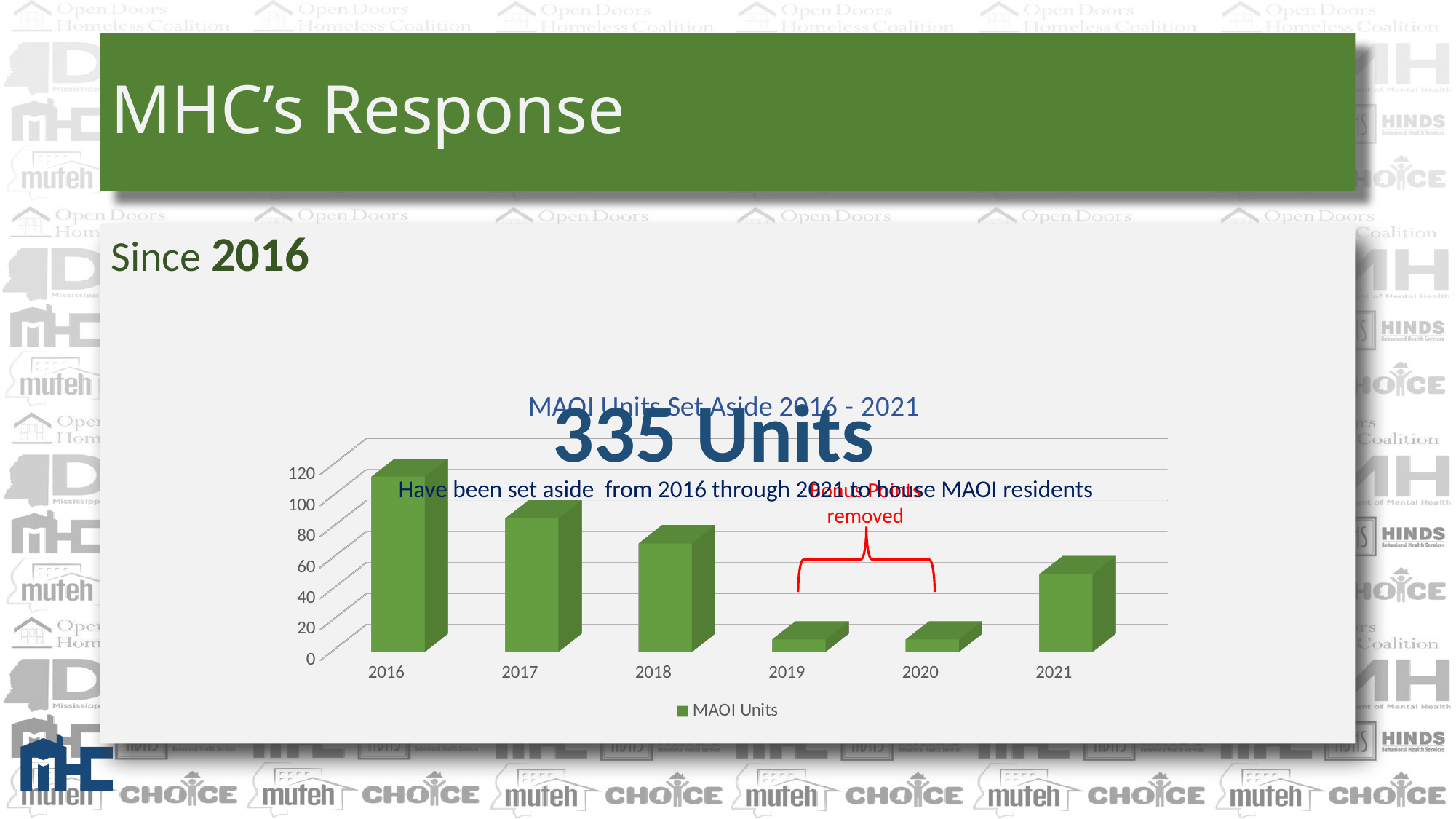
Which year has the highest number of MAOI units set aside? 2016 What kind of chart is shown on the slide? Bar chart How many years are shown on the x axis of the chart? 6 Is the value for 2018 greater or less than 60? greater Which year has the larger value, 2017 or 2018? 2017 What is the title of the chart? MAOI Units Set Aside 2016 - 2021 How many series does the chart legend list? 1 Is the value for 2021 greater or less than 40? greater Is the value for 2016 greater or less than 100? greater What series name appears in the chart legend? MAOI Units Do the values rise or fall from 2016 to 2019? fall